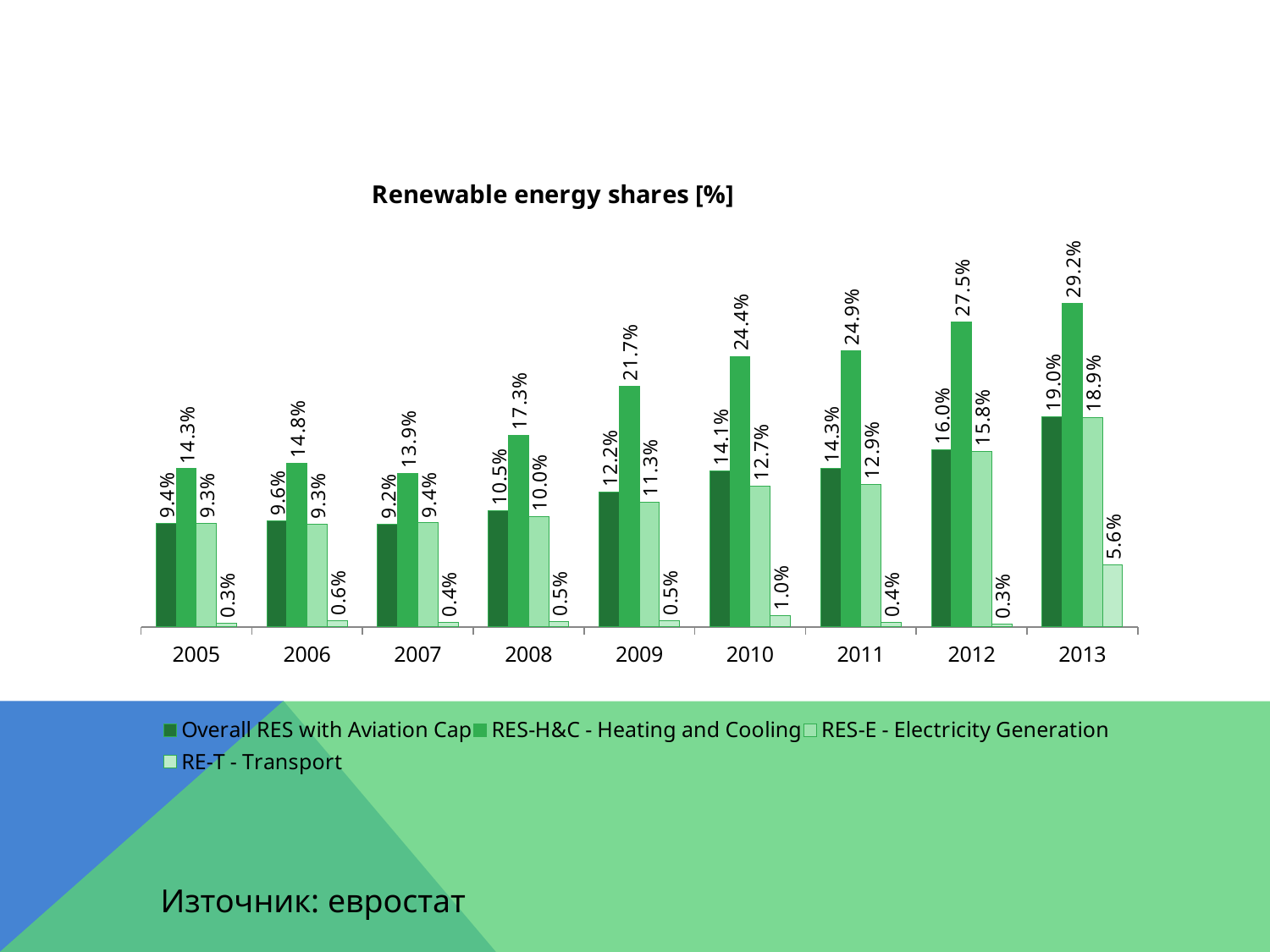
In which year is the RES-H&C - Heating and Cooling share lowest? 2007 In which year is the RES-E - Electricity Generation share highest? 2013 What kind of chart is shown on the slide? Bar chart Which is larger in 2009: the Overall RES with Aviation Cap share or the RES-E - Electricity Generation share? Overall RES with Aviation Cap Does the RES-H&C - Heating and Cooling share generally rise or fall from 2007 to 2013? Rise How many years are shown on the x axis? 9 What is the RE-T - Transport share in 2010? 1.0% What is the Overall RES with Aviation Cap share in 2008? 10.5% What is the RES-H&C - Heating and Cooling share in 2013? 29.2% How many series does the legend list? 4 What is the difference between the RES-H&C - Heating and Cooling share and the Overall RES with Aviation Cap share in 2012? 11.5% What is the title of the chart? Renewable energy shares [%]